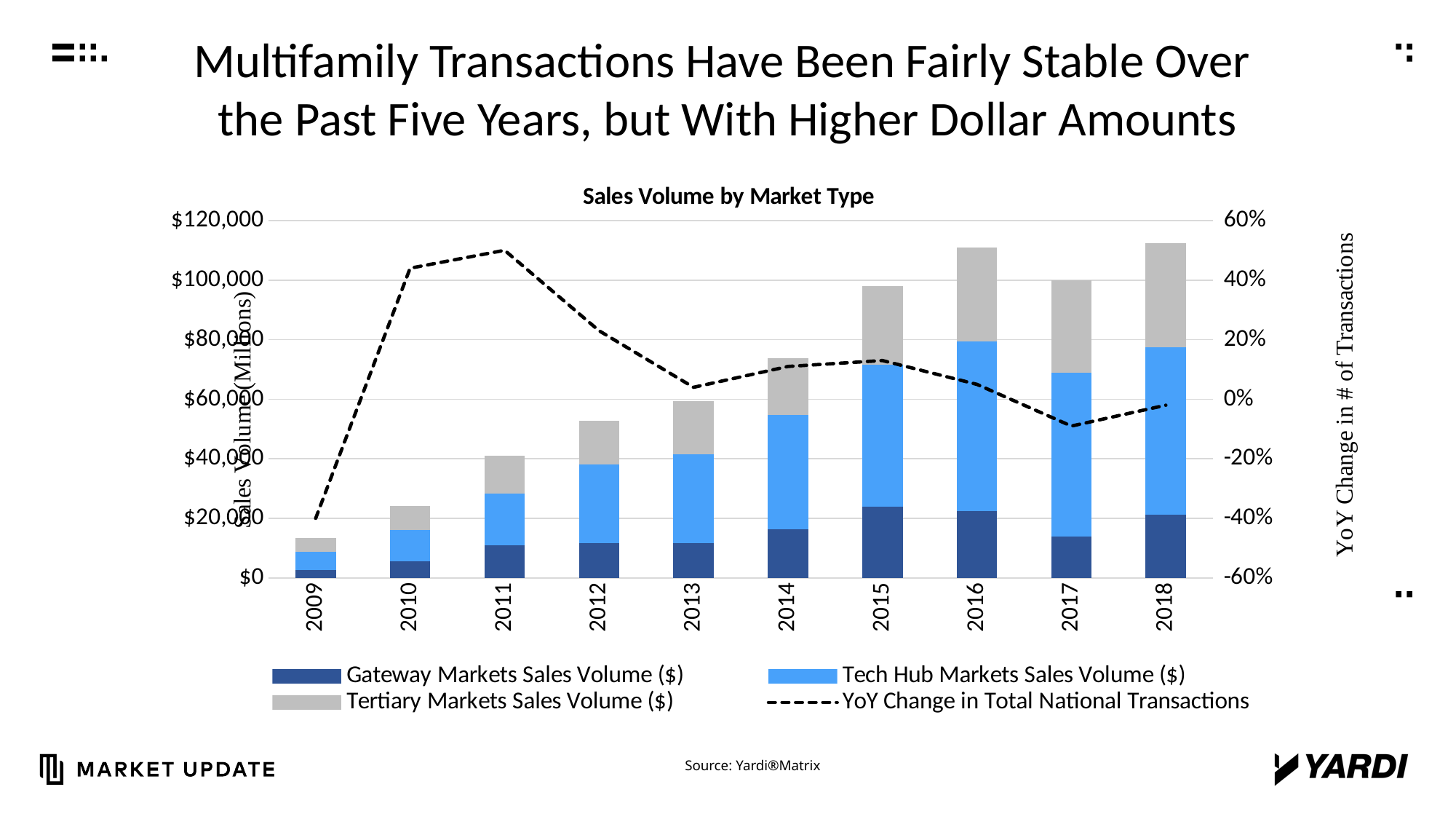
Which year has the lowest total sales volume? 2009 Does the total sales volume rise or fall from 2009 to 2016? rise What kind of chart is this? Bar chart with a line Is the total sales volume for 2009 greater or less than $20,000? less How many years are shown on the x axis? 10 How many series does the legend list? 4 Which year has the larger total sales volume, 2013 or 2015? 2015 Is the total sales volume for 2014 greater or less than $60,000? greater In which year is the YoY Change in Total National Transactions line at its lowest point? 2009 What is the title of the chart? Sales Volume by Market Type Is the total sales volume for 2015 greater or less than $80,000? greater In which year does the YoY Change in Total National Transactions line reach its highest point? 2011